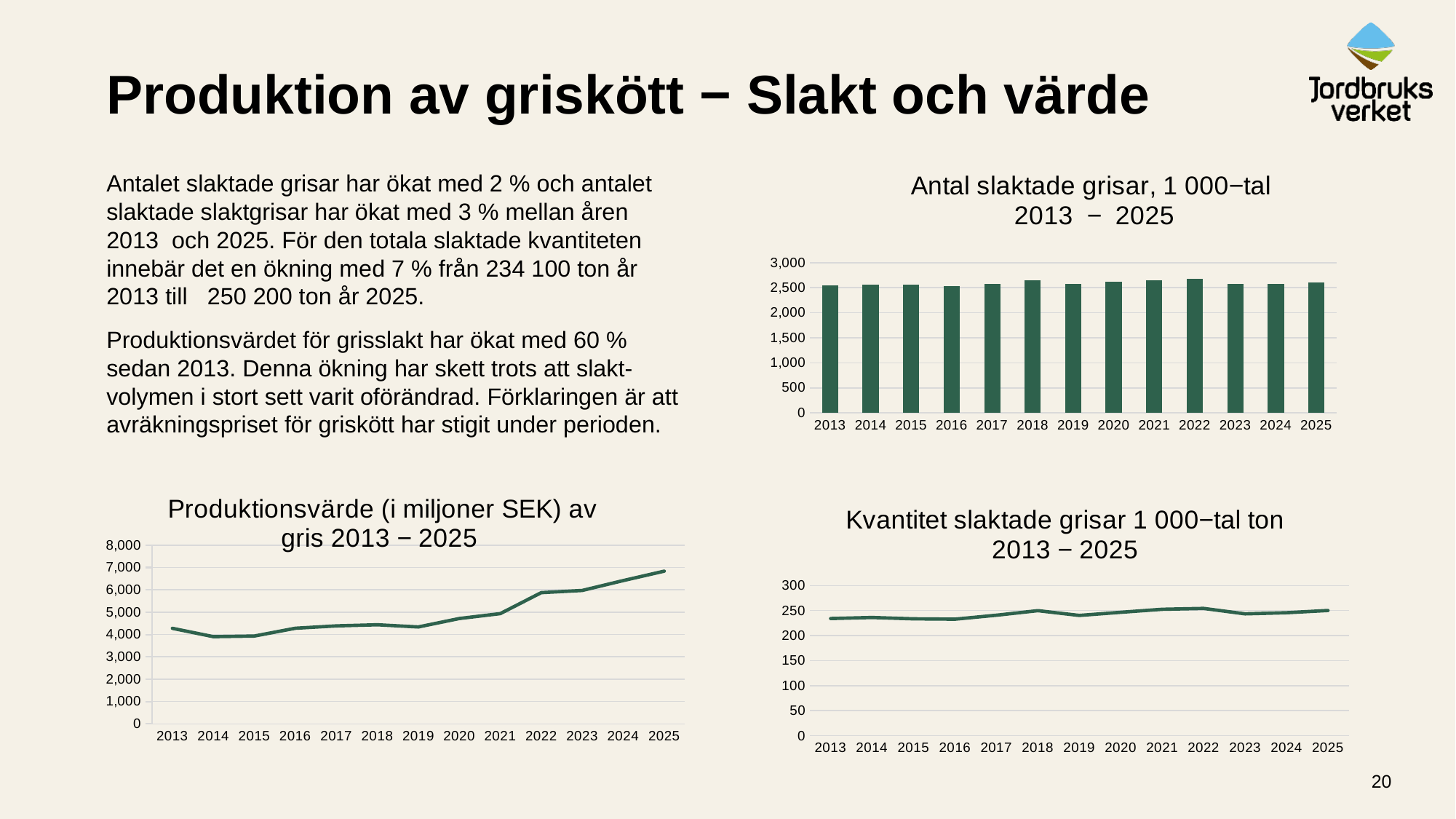
In the 'Antal slaktade grisar' bar chart, is the value for 2022 greater or less than 3,000? less What kind of chart is the 'Antal slaktade grisar, 1 000−tal 2013 − 2025' chart? bar chart In the 'Produktionsvärde (i miljoner SEK) av gris' line chart, do the values generally rise or fall from 2013 to 2025? rise In the 'Kvantitet slaktade grisar 1 000−tal ton' line chart, is the value for 2013 greater or less than 250? less In the 'Produktionsvärde (i miljoner SEK) av gris' line chart, which year has the highest value? 2025 How many data points are plotted in the 'Kvantitet slaktade grisar 1 000−tal ton' line chart? 13 In the 'Antal slaktade grisar' bar chart, is the value for 2013 greater or less than 2,000? greater In the 'Produktionsvärde (i miljoner SEK) av gris' line chart, which is larger, the value for 2022 or the value for 2019? 2022 What kind of chart is the 'Produktionsvärde (i miljoner SEK) av gris 2013 − 2025' chart? line chart How many years are shown on the x axis of the 'Antal slaktade grisar' bar chart? 13